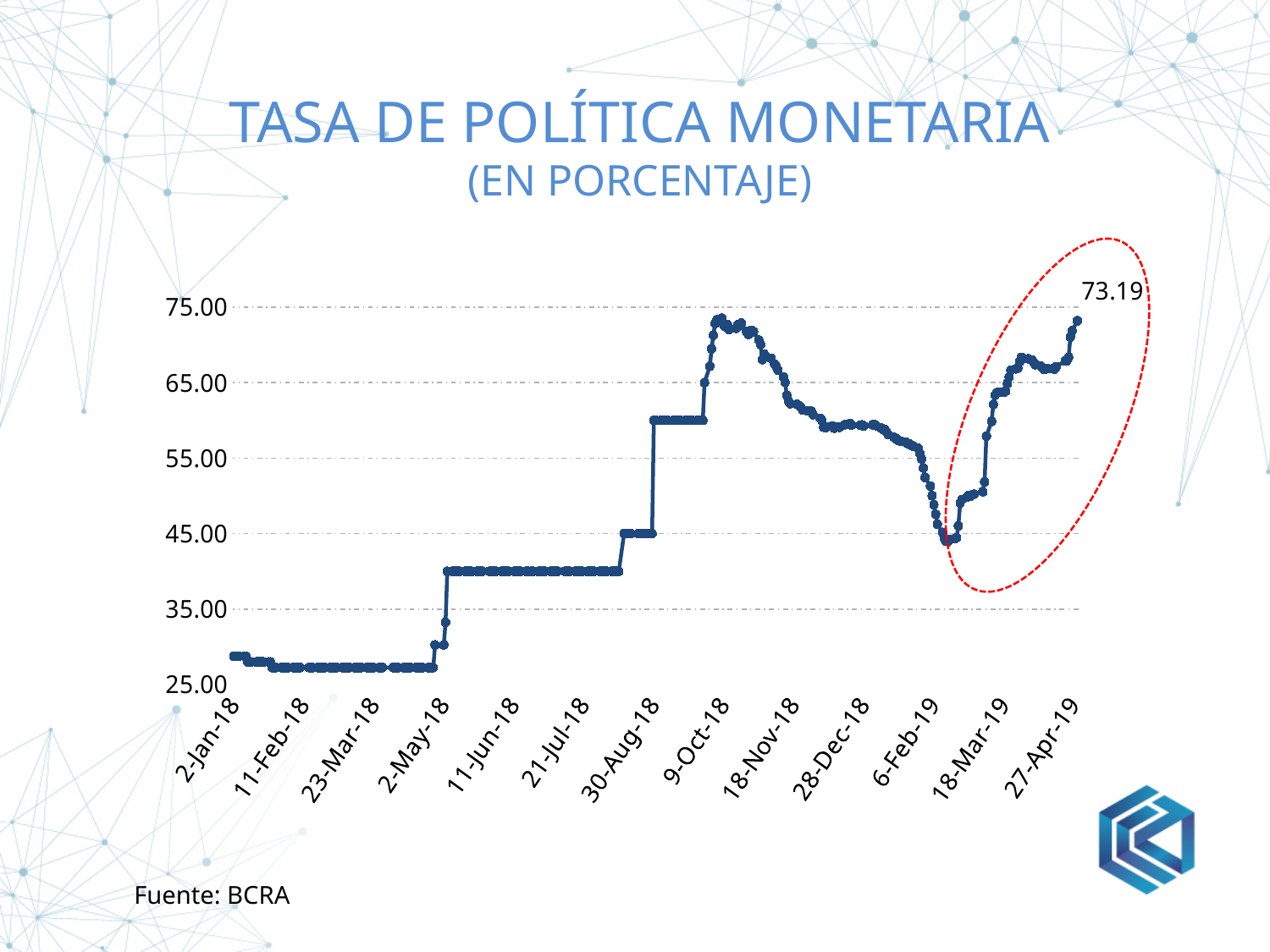
Is the value at 2-May-18 greater or less than 35.00? less What kind of chart is shown on the slide? line chart Does the series rise or fall between 2-Jan-18 and 9-Oct-18? rise What is the title of the chart? TASA DE POLÍTICA MONETARIA (EN PORCENTAJE) Does the series rise or fall between 9-Oct-18 and 6-Feb-19? fall Is the value at 9-Oct-18 greater or less than 65.00? greater Is the value at 27-Apr-19 greater or less than 65.00? greater What source is cited for the chart data? BCRA Which is larger, the value at 2-Jan-18 or the value at 27-Apr-19? 27-Apr-19 What is the value of the last data point labelled on the chart? 73.19